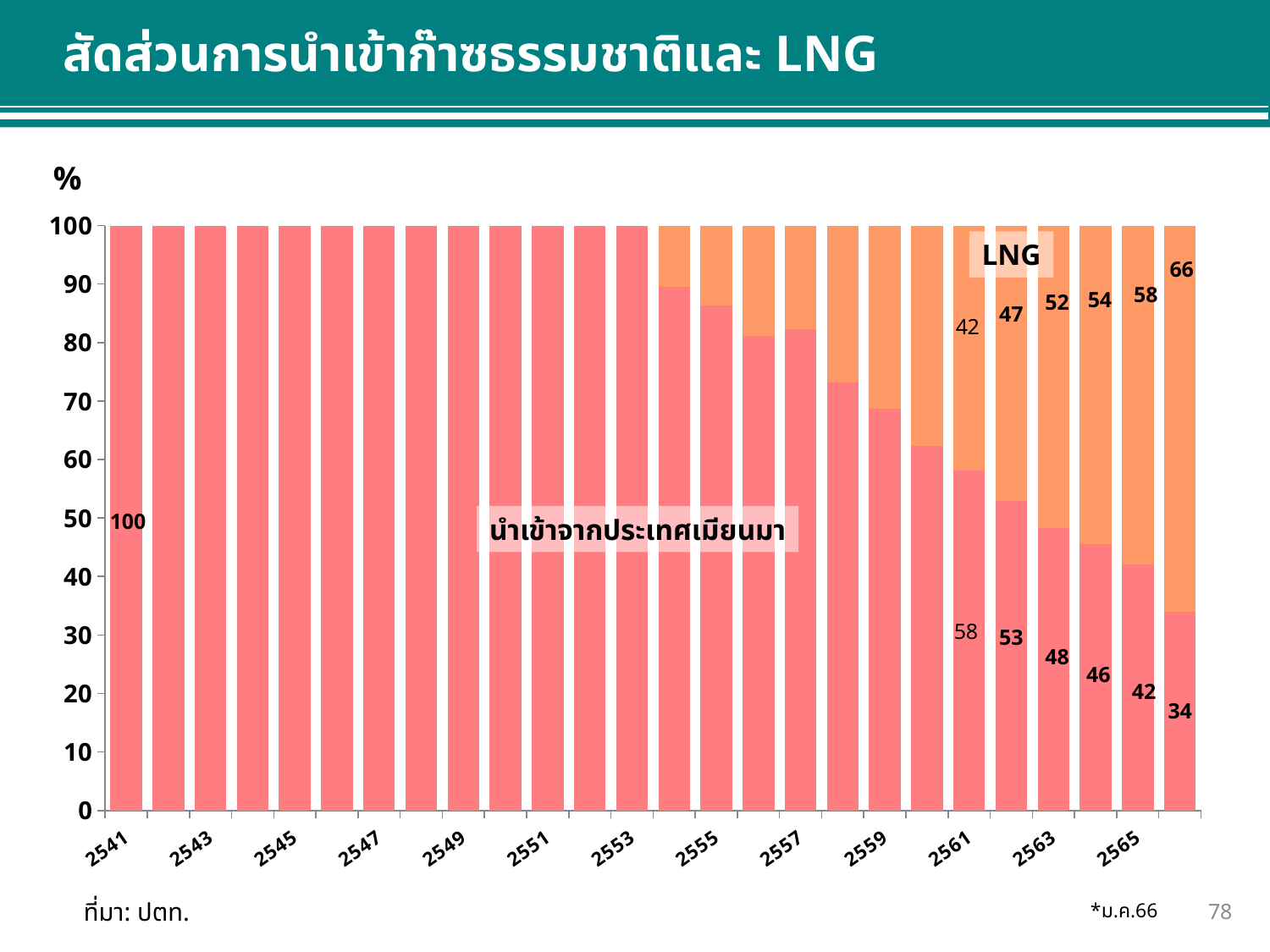
What value is labelled on the bar for 2541? 100 What is the share of imports from Myanmar in 2566? 34 What is the LNG share in 2561? 42 In 2563, which is larger: the LNG share or the share from Myanmar? LNG Is the share of imports from Myanmar in 2555 greater or less than 80? greater Is the share of imports from Myanmar in 2558 greater or less than 90? less Which year has the highest LNG share? 2566 What is the total of the stacked bar for 2564? 100 In 2566, how much larger is the LNG share than the share from Myanmar? 32 Does the share of imports from Myanmar rise or fall from 2561 to 2566? fall What is the LNG share in 2565? 58 What kind of chart is shown on the slide? stacked bar chart